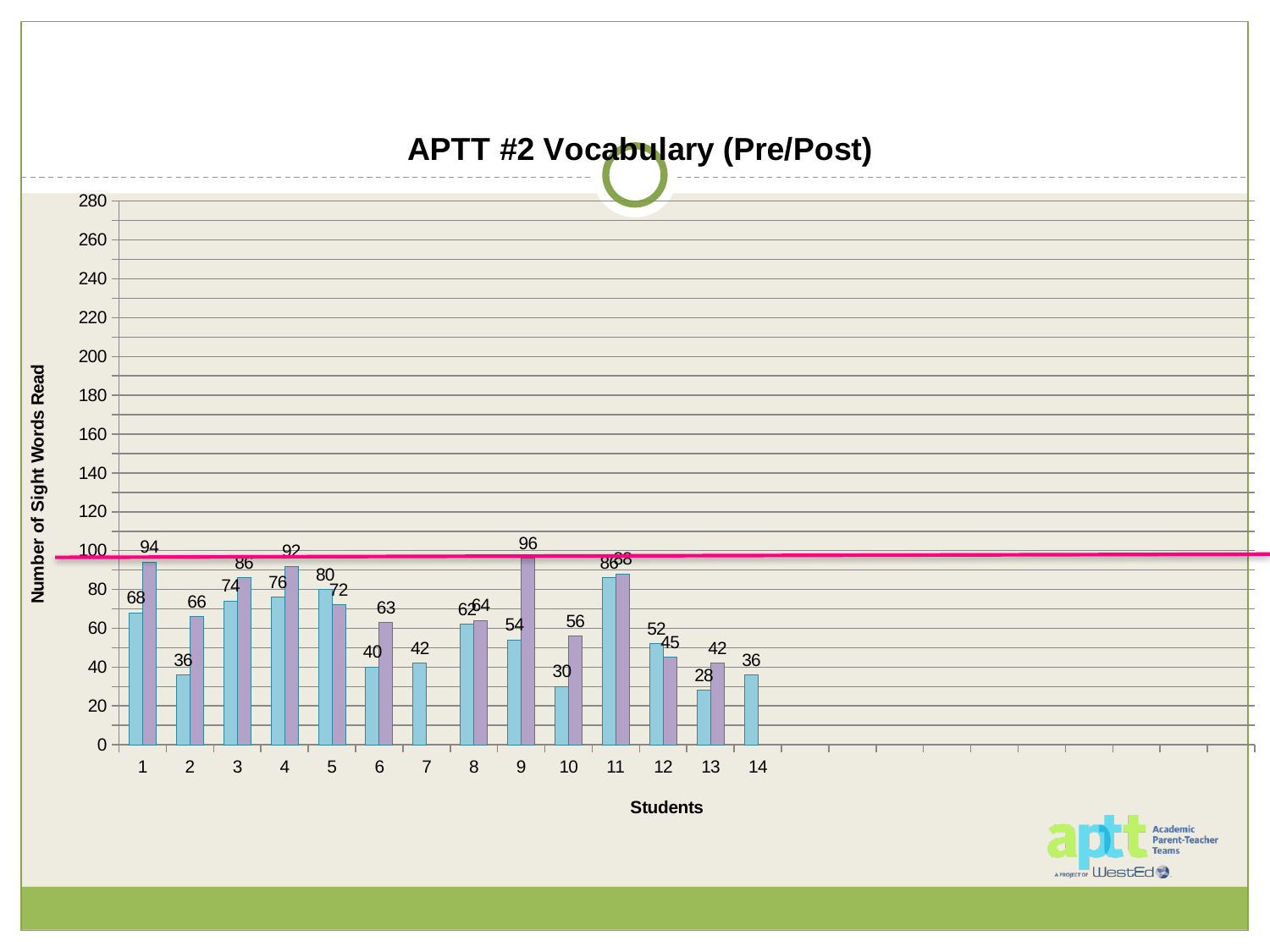
How many students are shown along the x axis of the chart? 14 What kind of chart is shown on the slide? bar chart Is the value of the blue (first) bar for student 10 greater or less than 40? less What is the value of the purple (second) bar for student 9? 96 Which student has the highest purple (second) bar? 9 What is the value of the single bar shown for student 7? 42 For student 5, which bar is larger, the blue (first) or the purple (second)? blue (first) What is the value of the blue (first) bar for student 1? 68 What is the title of the chart? APTT #2 Vocabulary (Pre/Post) For student 1, how much higher is the purple (second) bar than the blue (first) bar? 26 What is the title of the y axis? Number of Sight Words Read Which student has the lowest blue (first) bar? 13